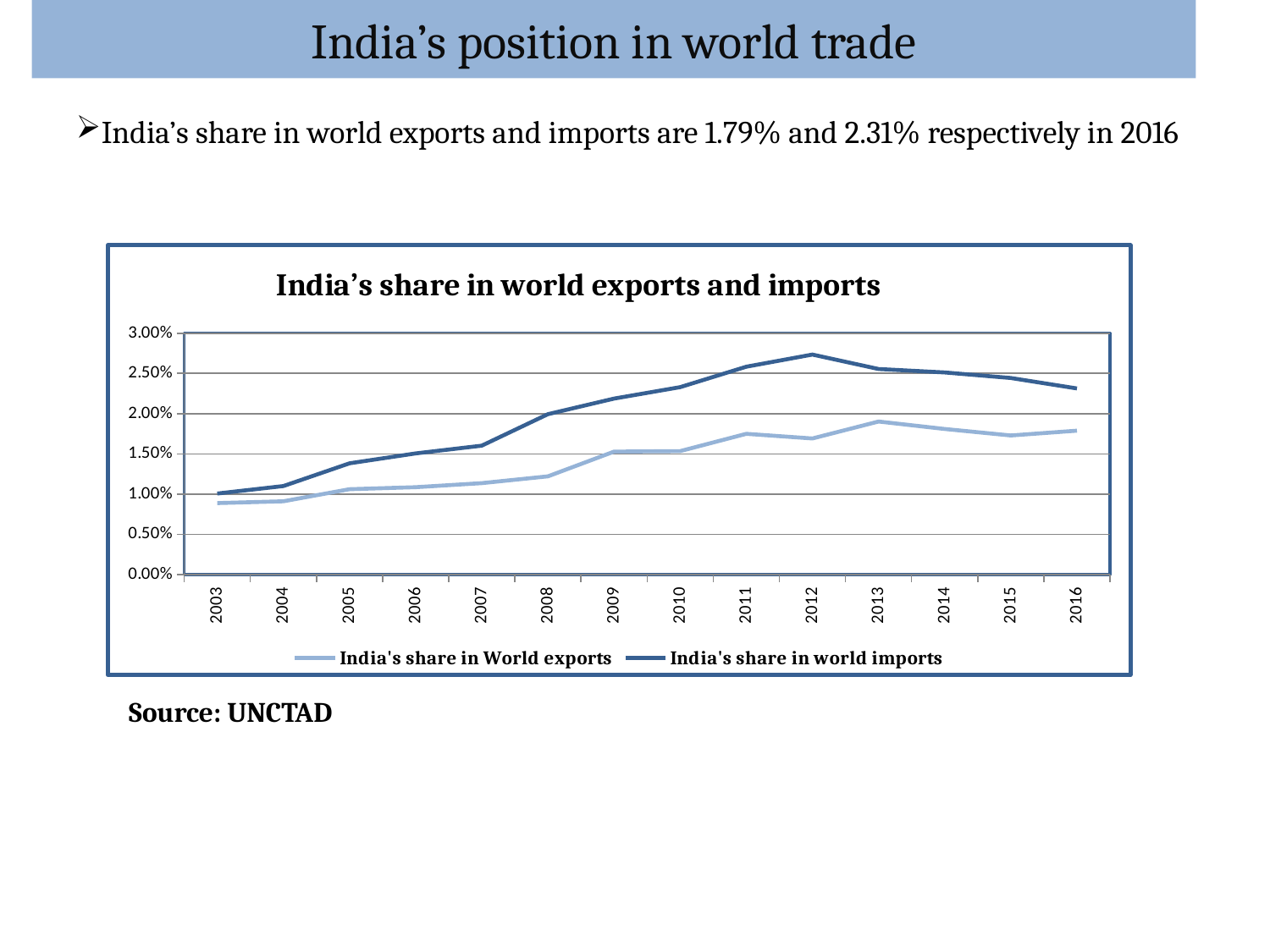
What kind of chart is shown on the slide? line chart What is India's share in world imports in 2016? 2.31% What is India's share in world exports in 2016? 1.79% What is the difference between India's share in world imports and its share in world exports in 2016? 0.52% Is India's share in world exports in 2003 greater or less than 1.00%? less In 2016, which is larger: India's share in world imports or its share in world exports? India's share in world imports In which year does India's share in world imports reach its highest point? 2012 In which year does India's share in world exports reach its highest point? 2013 Is India's share in world imports in 2012 greater or less than 2.50%? greater How many years are plotted along the x axis of the chart? 14 Does India's share in world exports generally rise or fall from 2003 to 2013? rise How many series does the legend of the chart list? 2